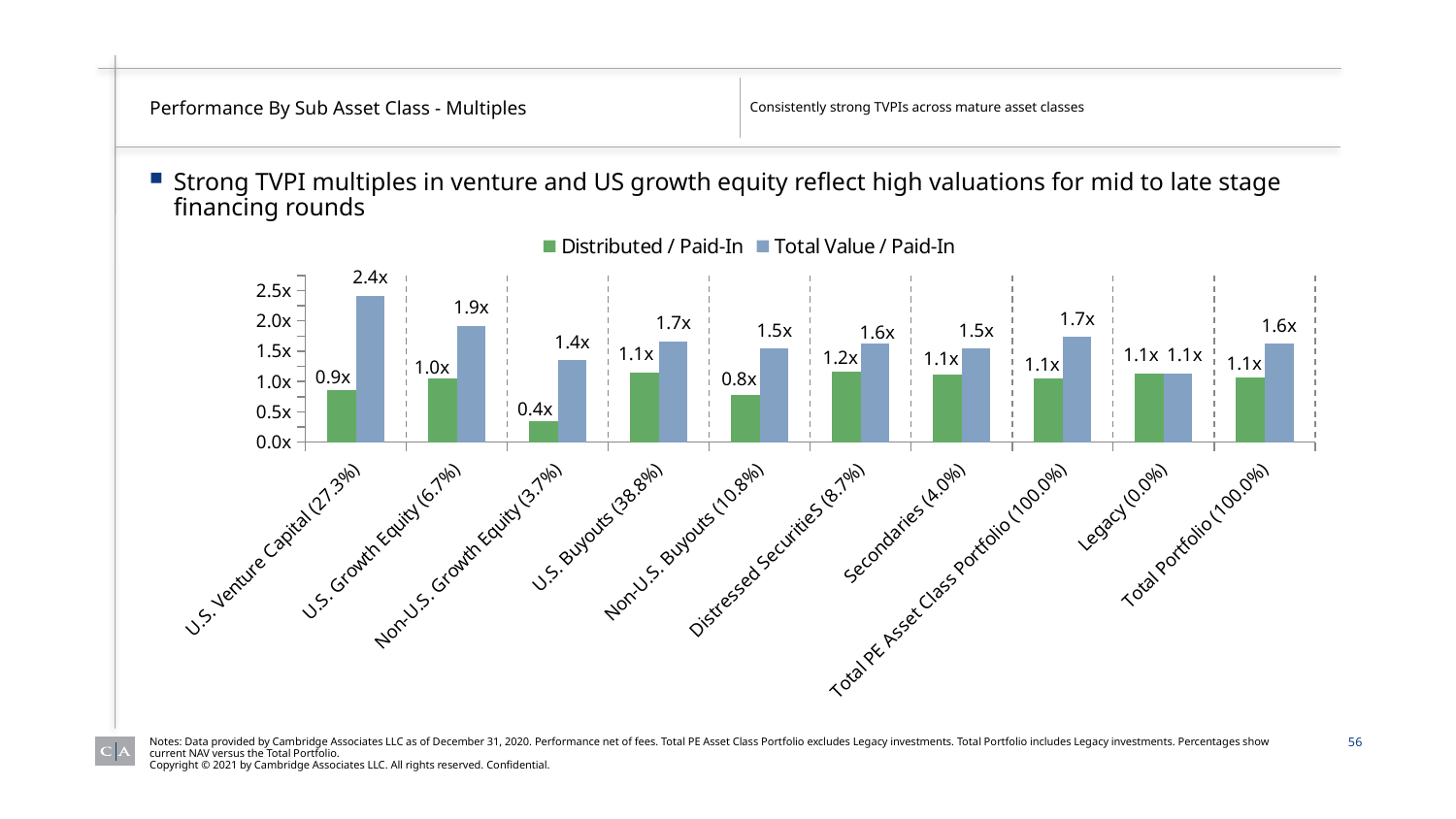
What is the difference between the Total Value / Paid-In multiples of U.S. Growth Equity (6.7%) and Non-U.S. Growth Equity (3.7%)? 0.5x What is the Total Value / Paid-In multiple for U.S. Venture Capital (27.3%)? 2.4x What is the difference between the Total Value / Paid-In and Distributed / Paid-In multiples for U.S. Venture Capital (27.3%)? 1.5x Which colour represents the Total Value / Paid-In series in the chart? Blue What is the Distributed / Paid-In multiple for Non-U.S. Buyouts (10.8%)? 0.8x What type of chart is shown on the slide? Bar chart What is the Total Value / Paid-In multiple for Total Portfolio (100.0%)? 1.6x Which category has the lowest Distributed / Paid-In multiple? Non-U.S. Growth Equity (3.7%) How many categories are shown on the x axis of the chart? 10 Which category has the highest Total Value / Paid-In multiple? U.S. Venture Capital (27.3%) How many series does the chart legend list? 2 Which is larger: the Distributed / Paid-In multiple for Distressed Securities (8.7%) or for Non-U.S. Buyouts (10.8%)? Distressed Securities (8.7%)